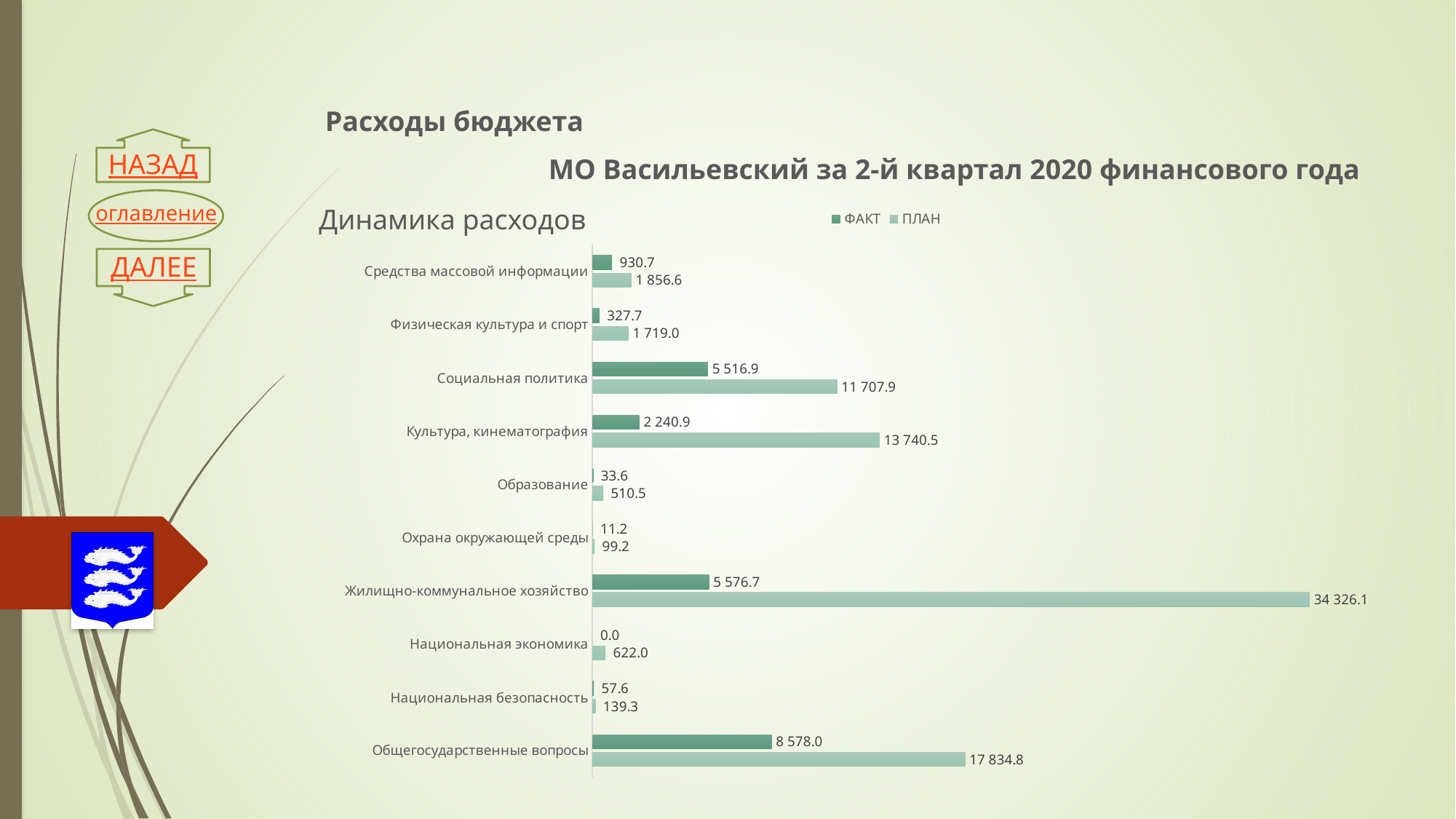
What is the ФАКТ value for Национальная экономика? 0.0 What is the difference between the ПЛАН and ФАКТ values for Общегосударственные вопросы? 9 256.8 What kind of chart is shown on the slide? Bar chart How many series does the legend list? 2 Which is larger: the ПЛАН value for Социальная политика or the ПЛАН value for Культура, кинематография? Культура, кинематография Which category has the highest ПЛАН value? Жилищно-коммунальное хозяйство How many categories are shown in the chart? 10 Which category has the lowest ПЛАН value? Охрана окружающей среды Which category has the highest ФАКТ value? Общегосударственные вопросы What is the difference between the ПЛАН and ФАКТ values for Жилищно-коммунальное хозяйство? 28 749.4 What is the ФАКТ value for Социальная политика? 5 516.9 What is the ПЛАН value for Культура, кинематография? 13 740.5